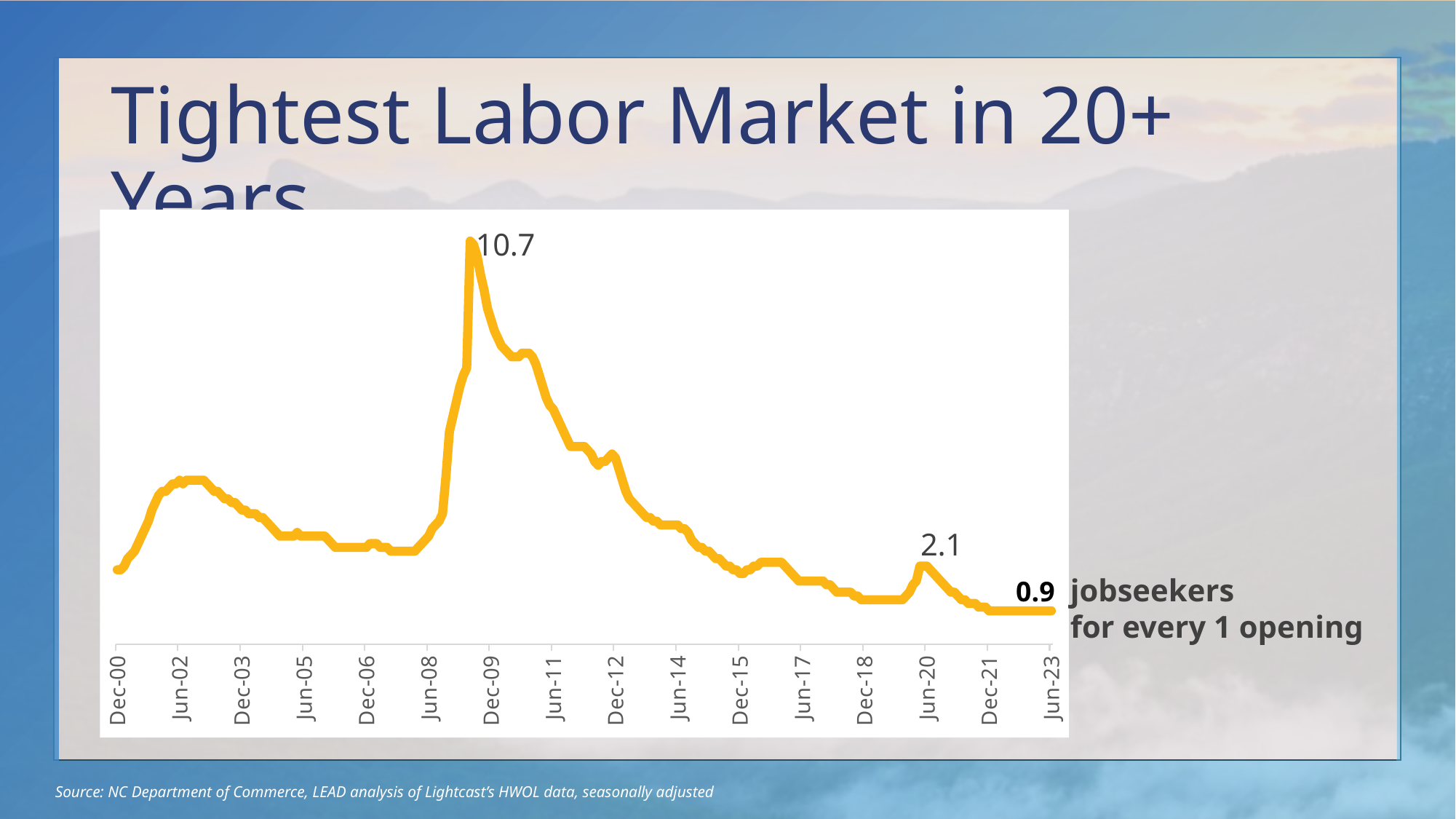
What value is labeled on the chart near Jun-20? 2.1 Does the line generally rise or fall from Dec-09 to Jun-23? fall What is the difference between the labeled values 10.7 and 2.1? 8.6 What kind of chart is shown on the slide? line chart How many date labels are shown on the x axis? 16 Which is larger: the value labeled near Jun-20 or the value labeled at Jun-23? Jun-20 What is the difference between the peak value of 10.7 and the Jun-23 value of 0.9? 9.8 What is the difference between the labeled values 2.1 and 0.9? 1.2 What is the value labeled at the end of the line, at Jun-23? 0.9 What is the title of the slide? Tightest Labor Market in 20+ Years What is the peak value labeled on the line chart? 10.7